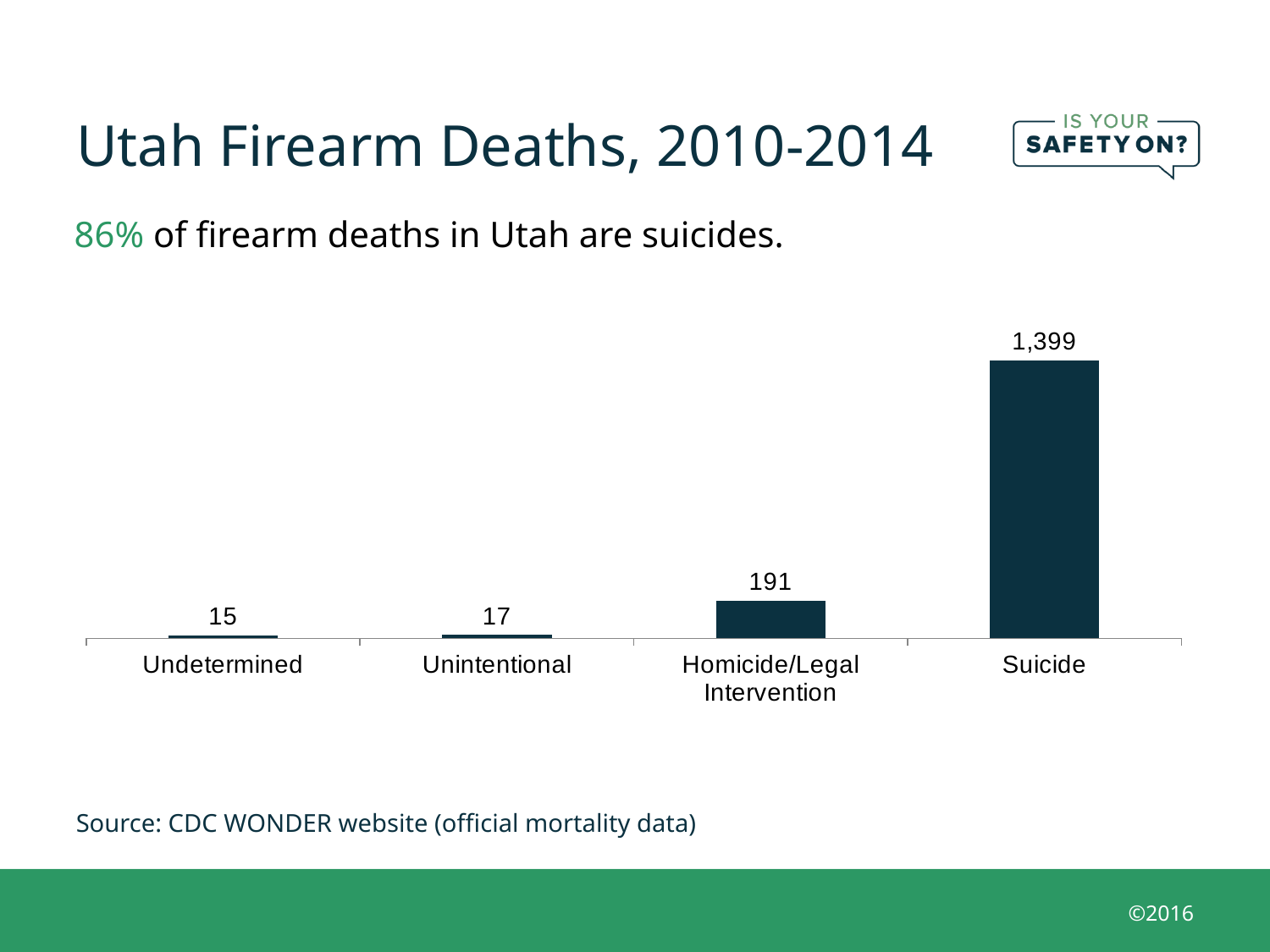
How many categories are shown on the x axis? 4 Which category has the lowest value? Undetermined What kind of chart is shown on the slide? Bar chart What is the title of the slide containing the chart? Utah Firearm Deaths, 2010-2014 What is the value for Undetermined? 15 What is the difference between the values for Suicide and Homicide/Legal Intervention? 1,208 What is the difference between the values for Unintentional and Undetermined? 2 What is the value for Suicide? 1,399 Which is larger, the value for Homicide/Legal Intervention or the value for Unintentional? Homicide/Legal Intervention Which category has the highest value? Suicide What is the value for Homicide/Legal Intervention? 191 What is the value for Unintentional? 17